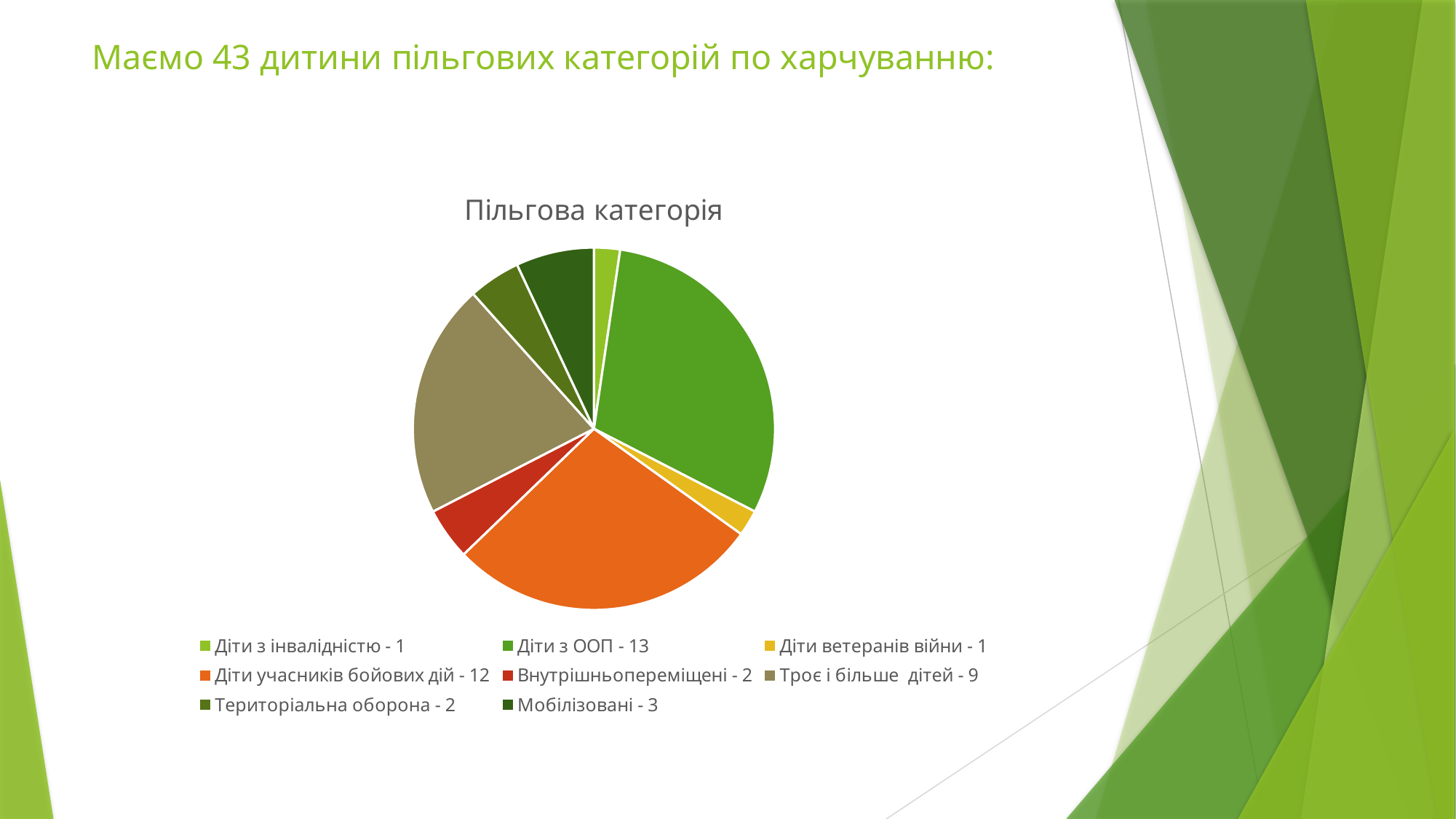
What is the value for Діти учасників бойових дій? 12 Which category has the largest value? Діти з ООП What is the title of the chart? Пільгова категорія What is the value for Троє і більше дітей? 9 How many categories does the pie chart have? 8 What is the value for Мобілізовані? 3 What is the difference between the values for Діти з ООП and Троє і більше дітей? 4 What kind of chart is shown on the slide? Pie chart What is the value for Внутрішньопереміщені? 2 Which is larger, the value for Мобілізовані or the value for Територіальна оборона? Мобілізовані What is the value for Діти з ООП? 13 What is the total number of children across all categories, as stated on the slide? 43